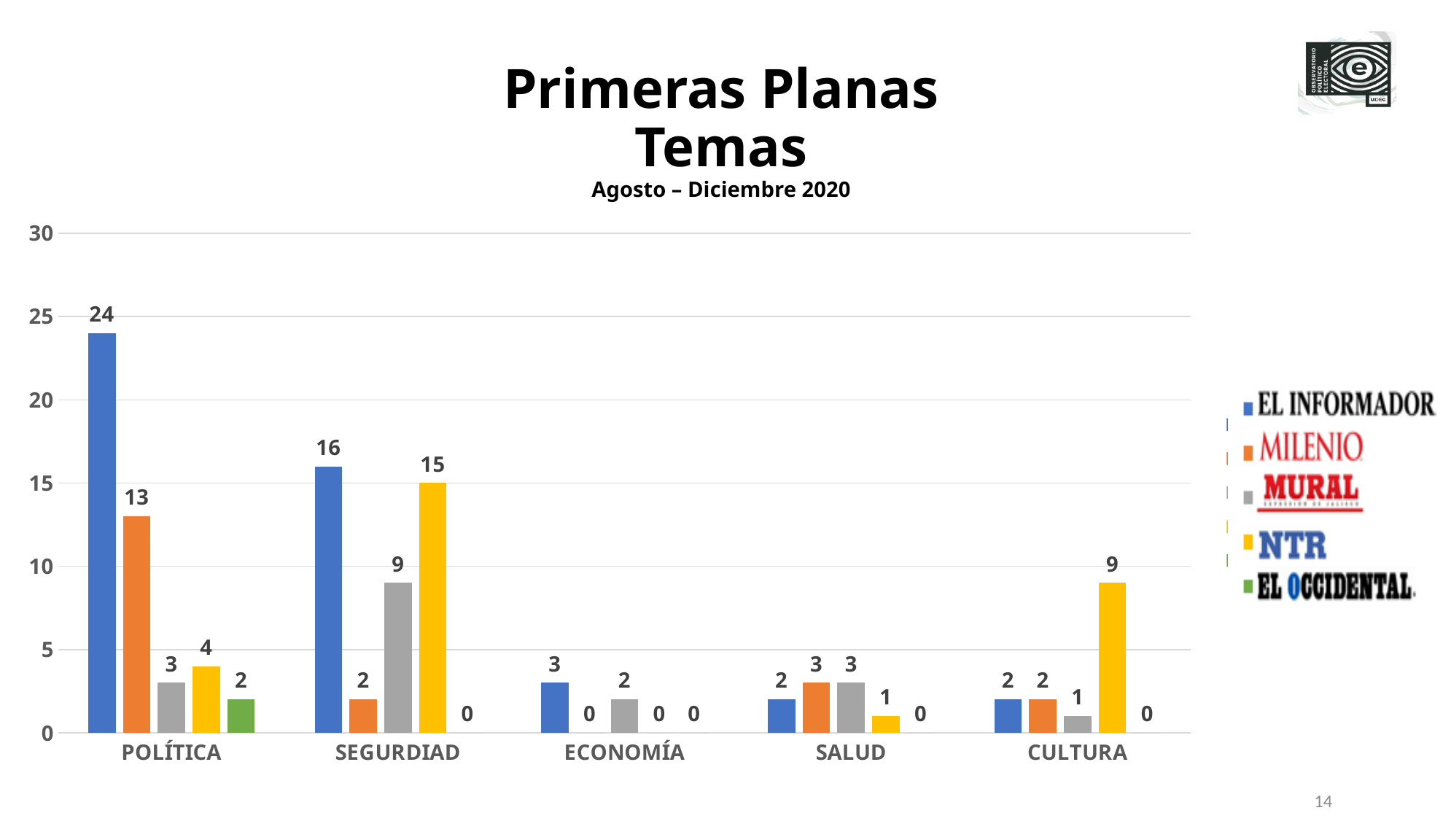
Which category has the highest value for El Informador? POLÍTICA What is the value for NTR in the SEGURDIAD category? 15 What is the value for El Informador in the POLÍTICA category? 24 What period is given in the subtitle of the chart? Agosto – Diciembre 2020 What is the value for Mural in the SALUD category? 3 What is the difference between El Informador and Milenio in the POLÍTICA category? 11 What kind of chart is shown on the slide? Bar chart How many categories are shown on the x axis? 5 How many series does the legend list? 5 Which is larger in the SEGURDIAD category: El Informador or NTR? El Informador Which category has the lowest value for Milenio? ECONOMÍA What is the value for NTR in the CULTURA category? 9